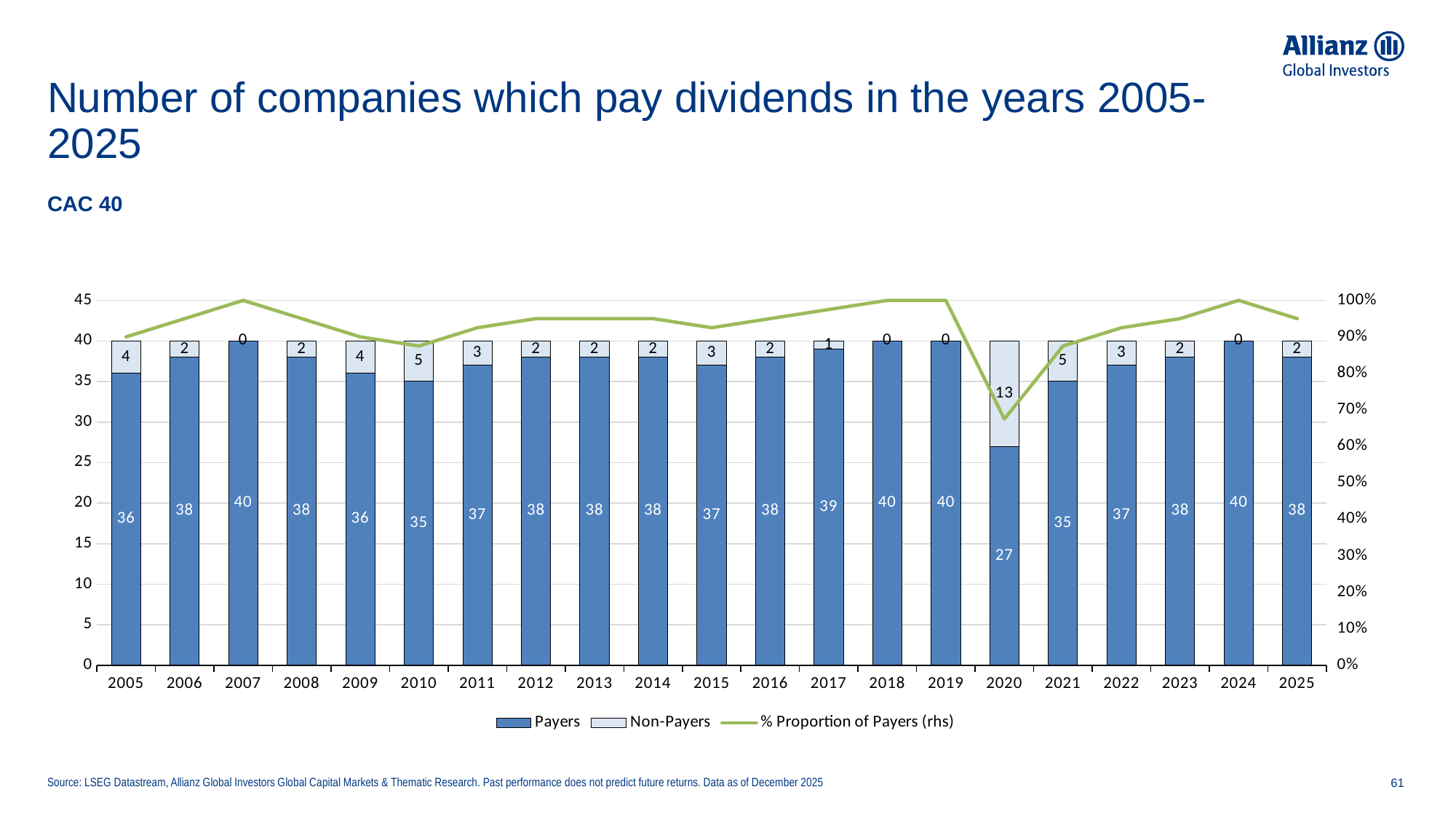
How many series does the legend list? 3 Which year has the highest number of Non-Payers? 2020 What is the number of Payers in 2020? 27 How many years are shown on the x axis? 21 Which year has the lowest number of Payers? 2020 What is the subtitle shown above the chart? CAC 40 Which is larger, the number of Payers in 2021 or in 2022? 2022 What is the number of Non-Payers in 2010? 5 What type of chart is shown on the slide? bar chart with a line Is the % Proportion of Payers in 2020 greater or less than 80%? less What is the total of the stacked bar for 2005 (Payers plus Non-Payers)? 40 What is the difference between the number of Payers in 2019 and in 2020? 13